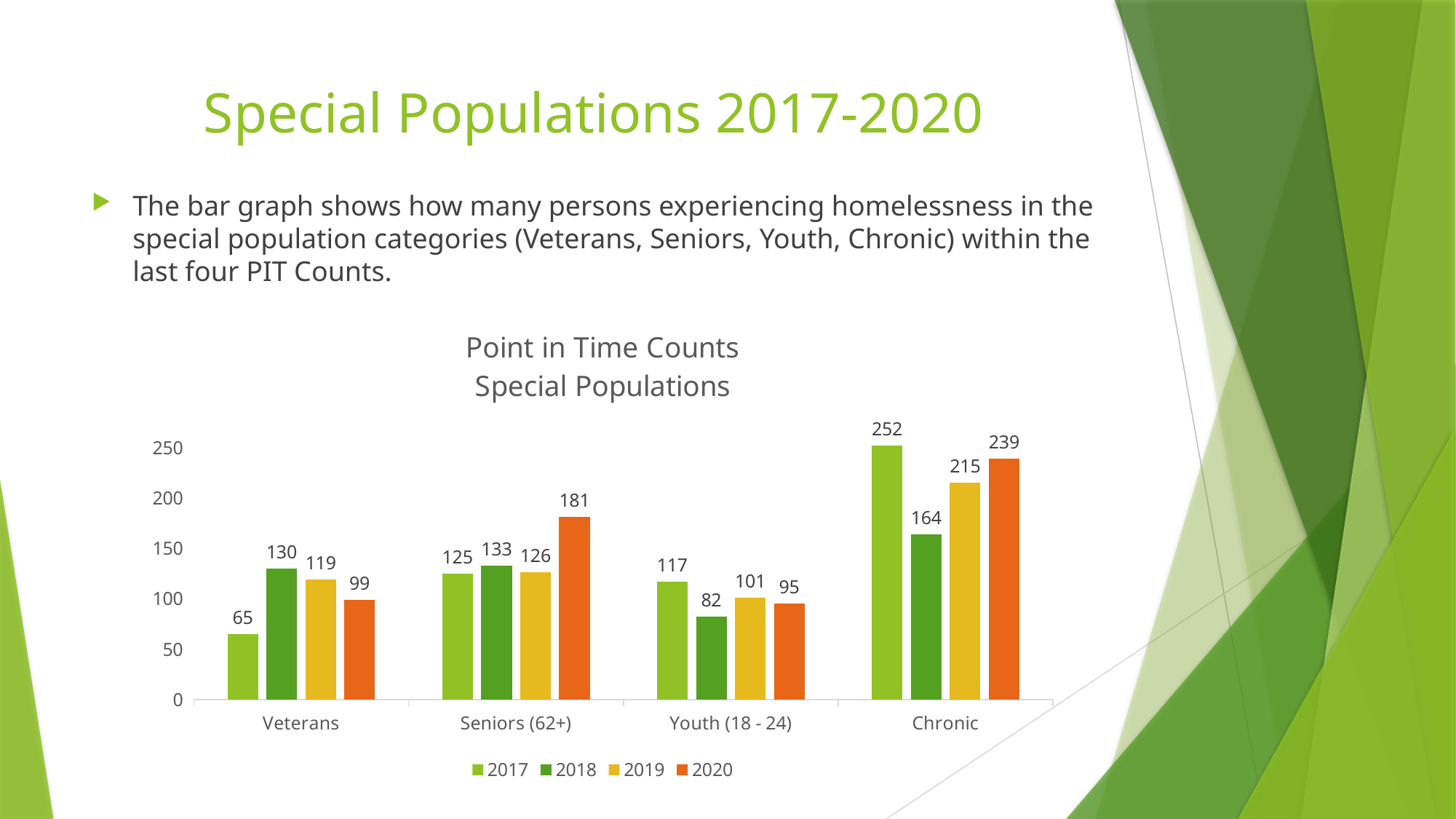
What kind of chart is shown? Bar chart Which category has the lowest 2020 value? Youth (18 - 24) Which is larger, the 2019 value for Veterans or the 2019 value for Seniors (62+)? Seniors (62+) What is the title of the chart? Point in Time Counts Special Populations Do the values for Veterans rise or fall from 2018 to 2020? Fall What is the difference between the 2017 and 2018 values for Chronic? 88 What is the 2020 value for Seniors (62+)? 181 How many categories are shown on the x axis? 4 Which category has the highest 2017 value? Chronic How many series does the legend list? 4 What is the 2017 value for Veterans? 65 What is the 2018 value for Youth (18 - 24)? 82